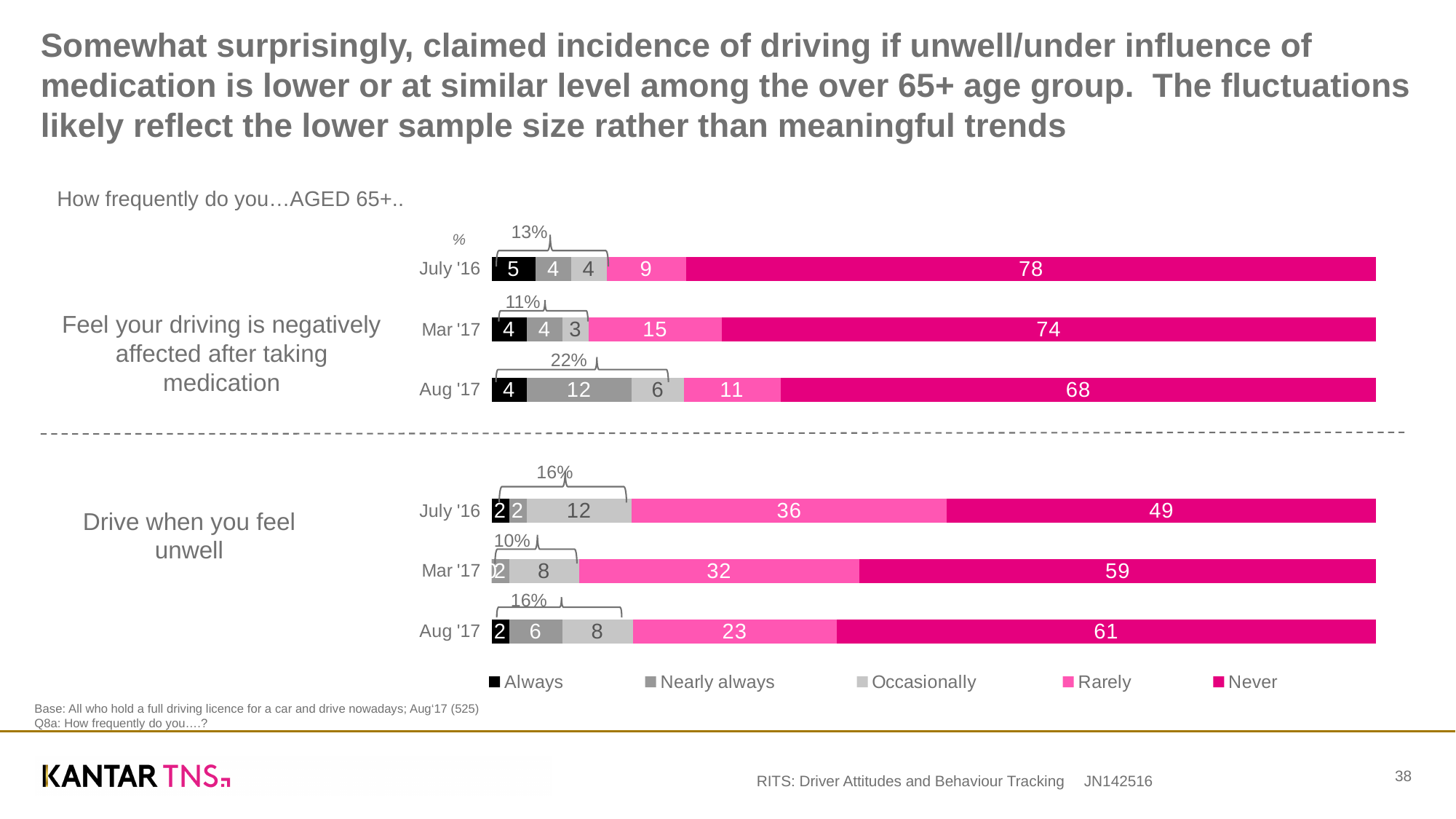
In the 'Feel your driving is negatively affected after taking medication' chart, which wave has the highest Never value? July '16 How many series does the legend list? 5 In the 'Feel your driving is negatively affected after taking medication' chart, does the Never value rise or fall from July '16 to Aug '17? Fall In the 'Feel your driving is negatively affected after taking medication' chart, what is the difference between the Never values for July '16 and Aug '17? 10 How many bars (waves) are shown in the 'Drive when you feel unwell' chart? 3 In the 'Feel your driving is negatively affected after taking medication' chart, what is the Nearly always value for Aug '17? 12 In the 'Feel your driving is negatively affected after taking medication' chart, what combined percentage is shown by the bracket above the Aug '17 bar? 22% In the 'Drive when you feel unwell' chart, what is the Rarely value for July '16? 36 In the 'Drive when you feel unwell' chart, which wave has the larger Rarely value, Mar '17 or Aug '17? Mar '17 In the 'Drive when you feel unwell' chart, which wave has the lowest Never value? July '16 In the 'Feel your driving is negatively affected after taking medication' chart, what is the Never value for Aug '17? 68 What kind of chart is used on this slide? Stacked bar chart